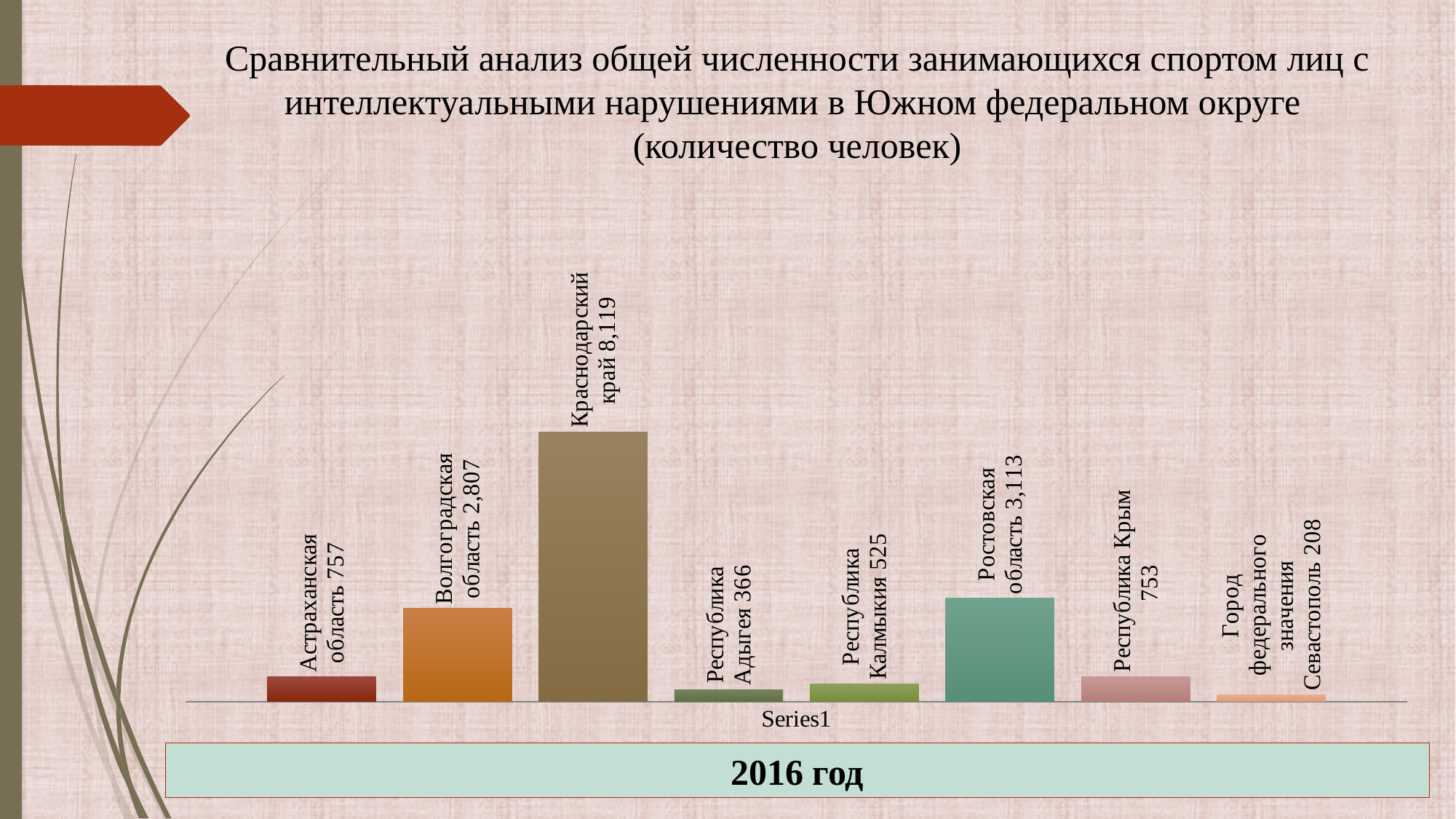
What is the value for Краснодарский край? 8,119 What kind of chart is shown on the slide? Bar chart Which region has the lowest value? Город федерального значения Севастополь What year is indicated below the chart? 2016 год What is the value for Ростовская область? 3,113 What is the value for Город федерального значения Севастополь? 208 How many regions are shown in the chart? 8 Which is larger, the value for Астраханская область or the value for Республика Калмыкия? Астраханская область What is the value for Республика Адыгея? 366 What is the difference between the values for Краснодарский край and Ростовская область? 5,006 What is the difference between the values for Ростовская область and Волгоградская область? 306 Which region has the highest value? Краснодарский край